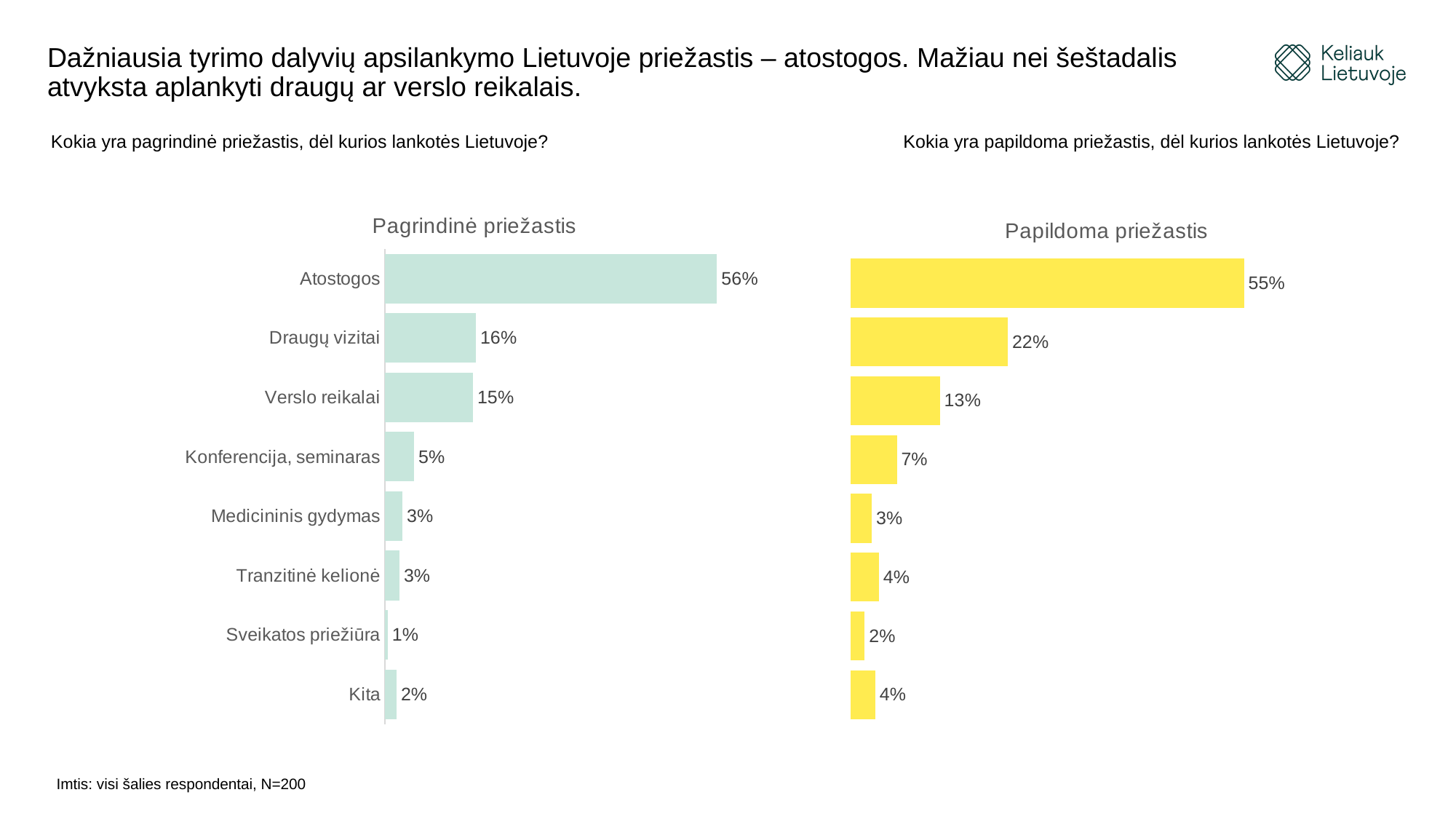
What type of chart is the 'Papildoma priežastis' chart? Bar chart In the 'Pagrindinė priežastis' chart, what is the value for Atostogos? 56% In the 'Pagrindinė priežastis' chart, which category has the lowest value? Sveikatos priežiūra How many categories are shown in the 'Pagrindinė priežastis' chart? 8 In the 'Pagrindinė priežastis' chart, which category has the highest value? Atostogos In the 'Papildoma priežastis' chart, what is the value for Draugų vizitai? 22% In the 'Papildoma priežastis' chart, what is the difference between Atostogos and Draugų vizitai? 33% In the 'Papildoma priežastis' chart, what is the value for Kita? 4% In the 'Papildoma priežastis' chart, which category has the lowest value? Sveikatos priežiūra Which is larger: Verslo reikalai in the 'Pagrindinė priežastis' chart or Verslo reikalai in the 'Papildoma priežastis' chart? Pagrindinė priežastis In the 'Pagrindinė priežastis' chart, what is the value for Konferencija, seminaras? 5% In the 'Pagrindinė priežastis' chart, what is the difference between Draugų vizitai and Verslo reikalai? 1%